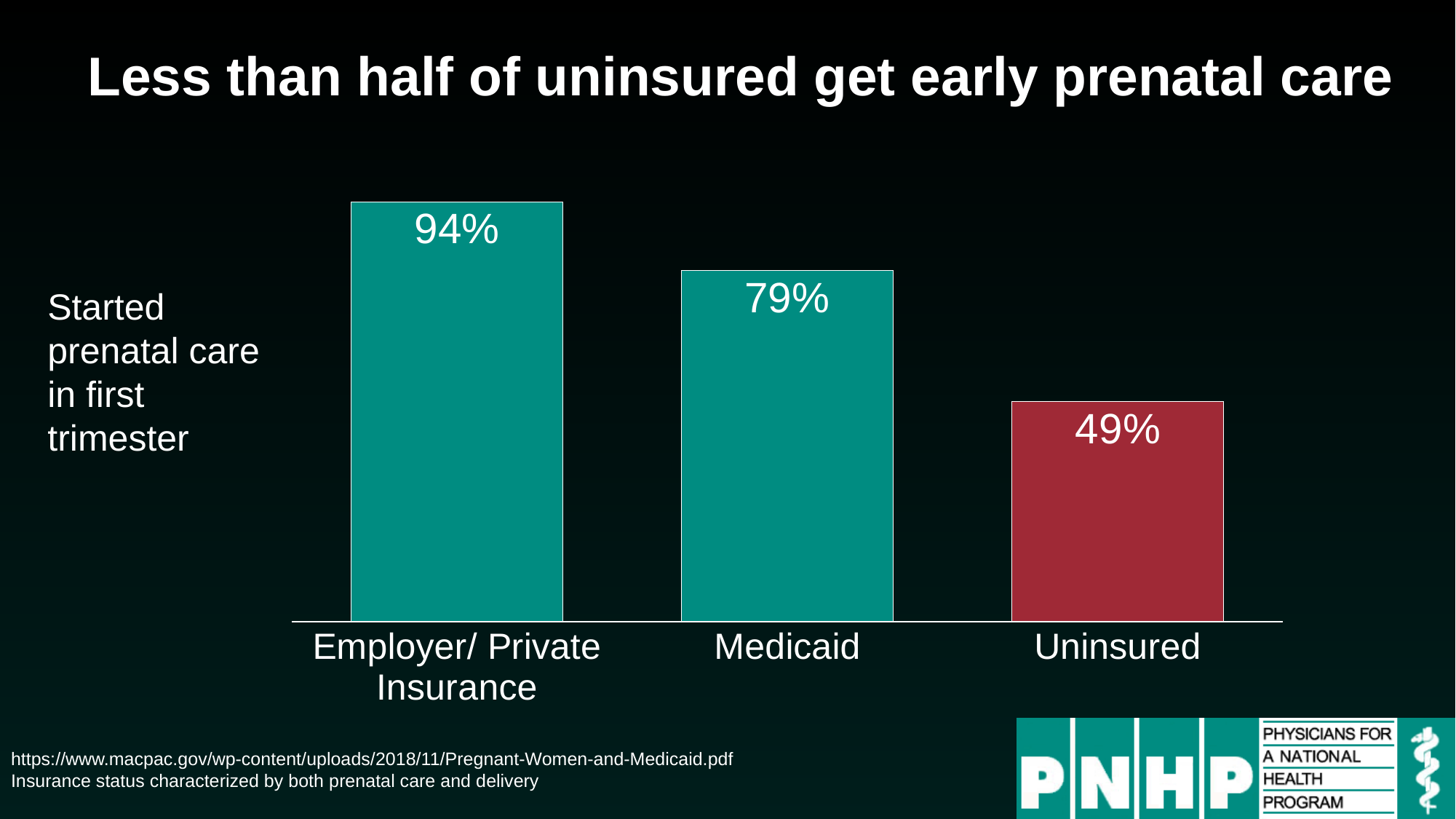
What percentage of women with Employer/ Private Insurance started prenatal care in the first trimester? 94% What is the difference in percentage points between Medicaid and Uninsured? 30 Do the values rise or fall from left to right across the categories? Fall What is the difference in percentage points between Employer/ Private Insurance and Uninsured? 45 What kind of chart is shown on the slide? Bar chart Which insurance category has the highest share starting prenatal care in the first trimester? Employer/ Private Insurance What percentage of women on Medicaid started prenatal care in the first trimester? 79% Which bar is coloured red rather than teal? Uninsured Which is larger, the value for Medicaid or the value for Uninsured? Medicaid What percentage of Uninsured women started prenatal care in the first trimester? 49% Which insurance category has the lowest share starting prenatal care in the first trimester? Uninsured How many insurance categories are shown in the chart? 3